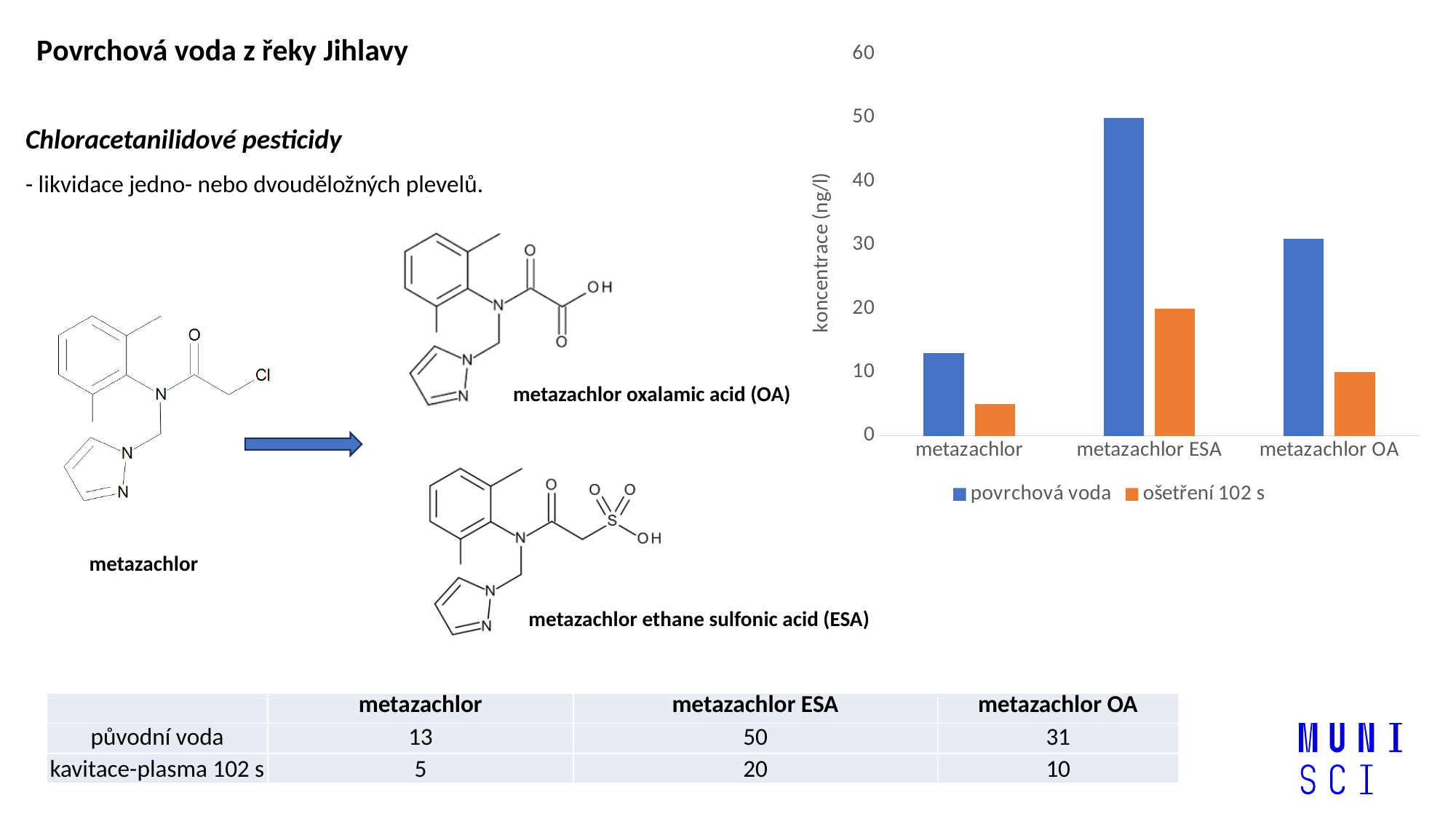
How many categories are shown on the x axis of the chart? 3 Is the ošetření 102 s value for metazachlor greater or less than 10? less Which category has the lowest ošetření 102 s value in the chart? metazachlor How many series does the chart legend list? 2 What is the label of the y axis of the chart? koncentrace (ng/l) Which is larger in the chart: the povrchová voda value for metazachlor or the povrchová voda value for metazachlor OA? metazachlor OA What is the ošetření 102 s value for metazachlor ESA in the chart? 20 Is the povrchová voda value for metazachlor OA greater or less than 20? greater What kind of chart is shown on the slide? bar chart What is the povrchová voda value for metazachlor ESA in the chart? 50 Which category has the highest povrchová voda value in the chart? metazachlor ESA What is the ošetření 102 s value for metazachlor OA in the chart? 10